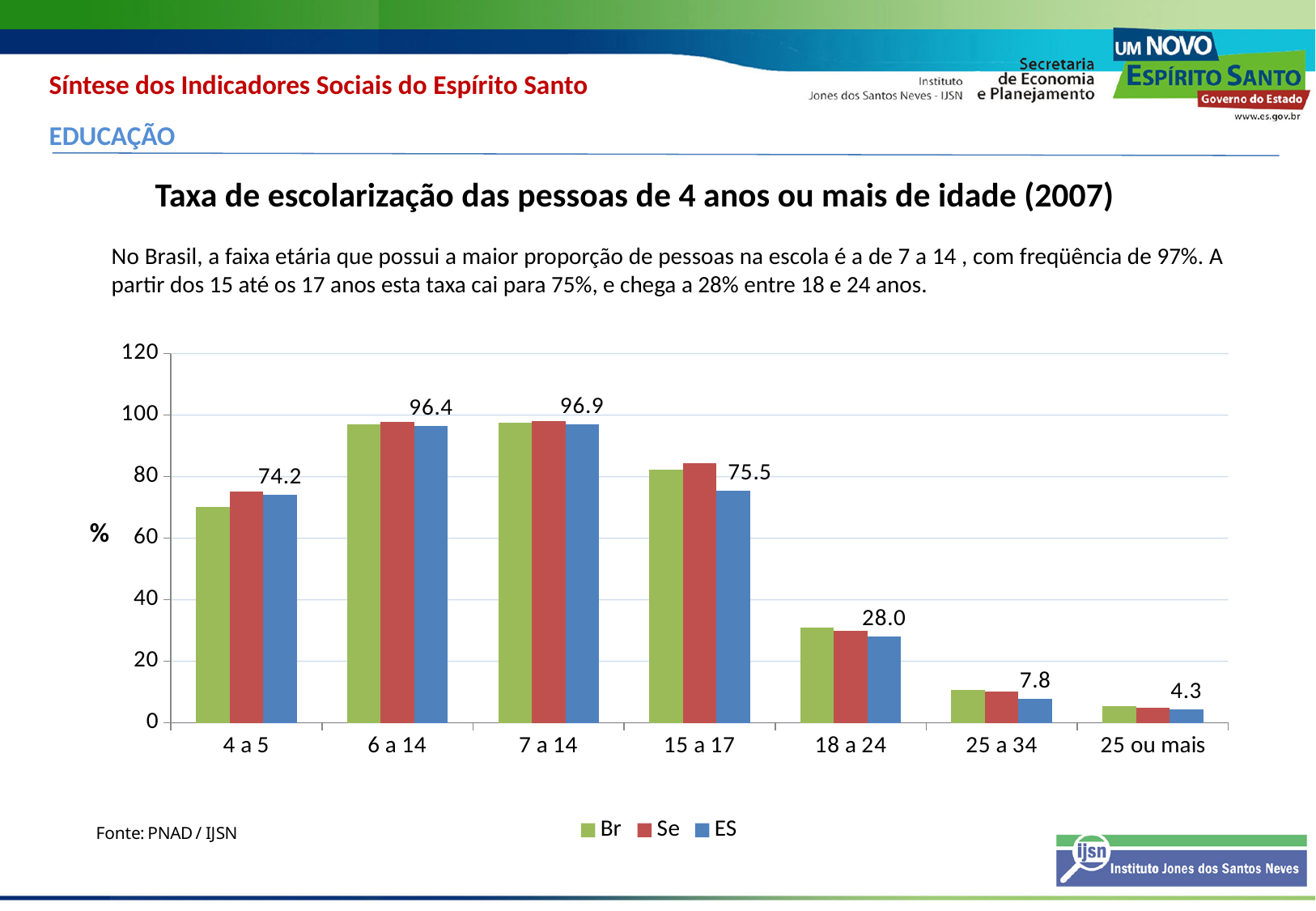
What is the difference between the ES values for 15 a 17 and 18 a 24? 47.5 Is the value for Br in the 4 a 5 age group greater or less than 80? less What is the value for ES in the 4 a 5 age group? 74.2 How many age groups are shown on the x axis? 7 What is the value for ES in the 25 ou mais age group? 4.3 How many series does the legend list? 3 Which is larger for ES: the value for 4 a 5 or the value for 15 a 17? 15 a 17 What is the value for ES in the 15 a 17 age group? 75.5 What is the value for ES in the 18 a 24 age group? 28.0 Which age group has the lowest value for ES? 25 ou mais What kind of chart is shown on the slide? bar chart What is the difference between the ES values for 25 a 34 and 25 ou mais? 3.5